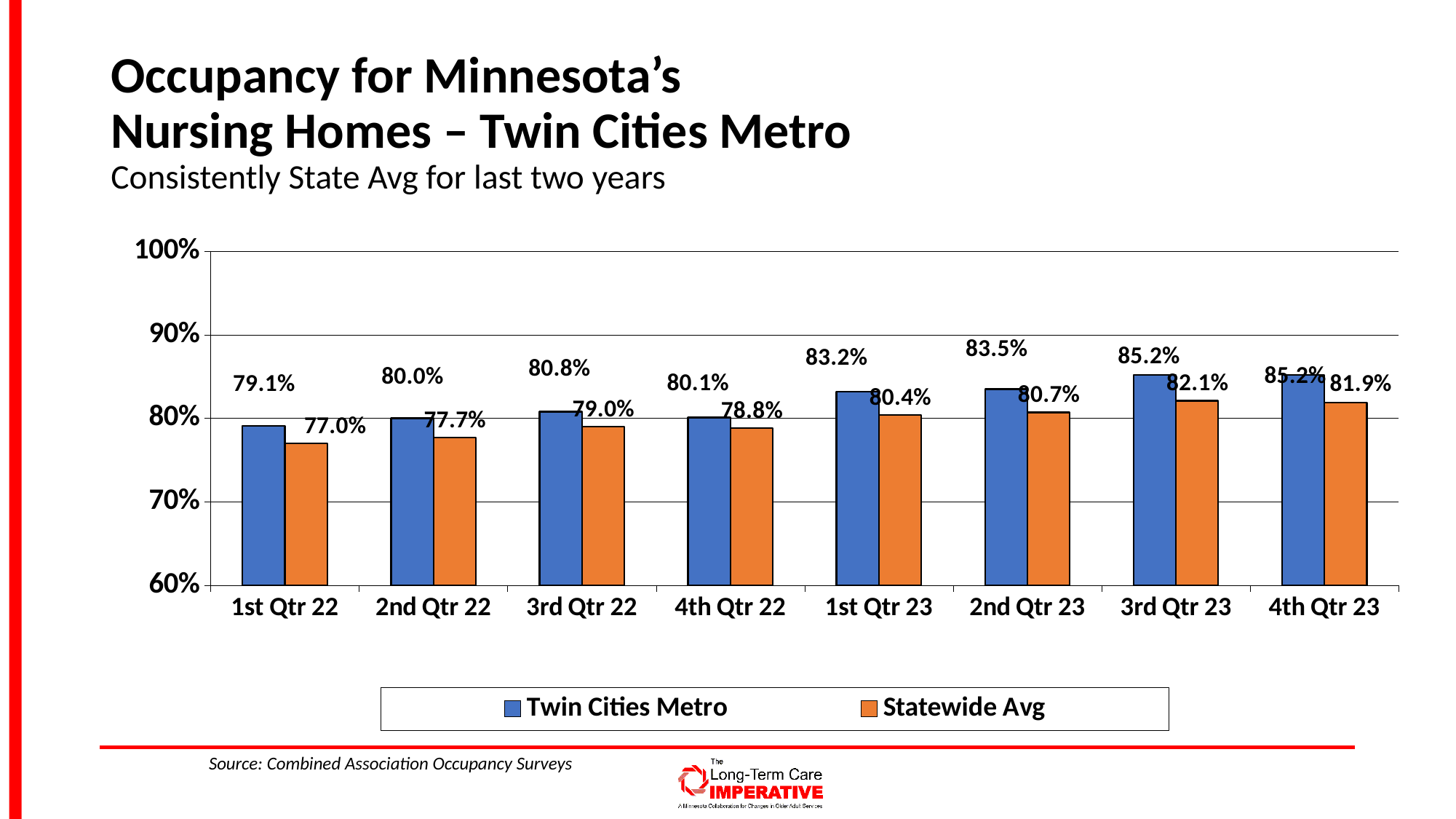
How many quarters are shown on the x axis? 8 What is the difference between the Twin Cities Metro and Statewide Avg occupancy in 1st Qtr 22? 2.1 percentage points How many series does the legend list? 2 What is the Statewide Avg occupancy for 4th Qtr 23? 81.9% In which quarter is the Statewide Avg occupancy lowest? 1st Qtr 22 What is the Twin Cities Metro occupancy for 1st Qtr 23? 83.2% Is the Statewide Avg occupancy for 1st Qtr 22 greater or less than 80%? less Which is larger in 3rd Qtr 23, the Twin Cities Metro occupancy or the Statewide Avg occupancy? Twin Cities Metro What is the Statewide Avg occupancy for 3rd Qtr 22? 79.0% What kind of chart is shown on the slide? Bar chart In which quarter is the Twin Cities Metro occupancy lowest? 1st Qtr 22 What is the Twin Cities Metro occupancy for 2nd Qtr 23? 83.5%